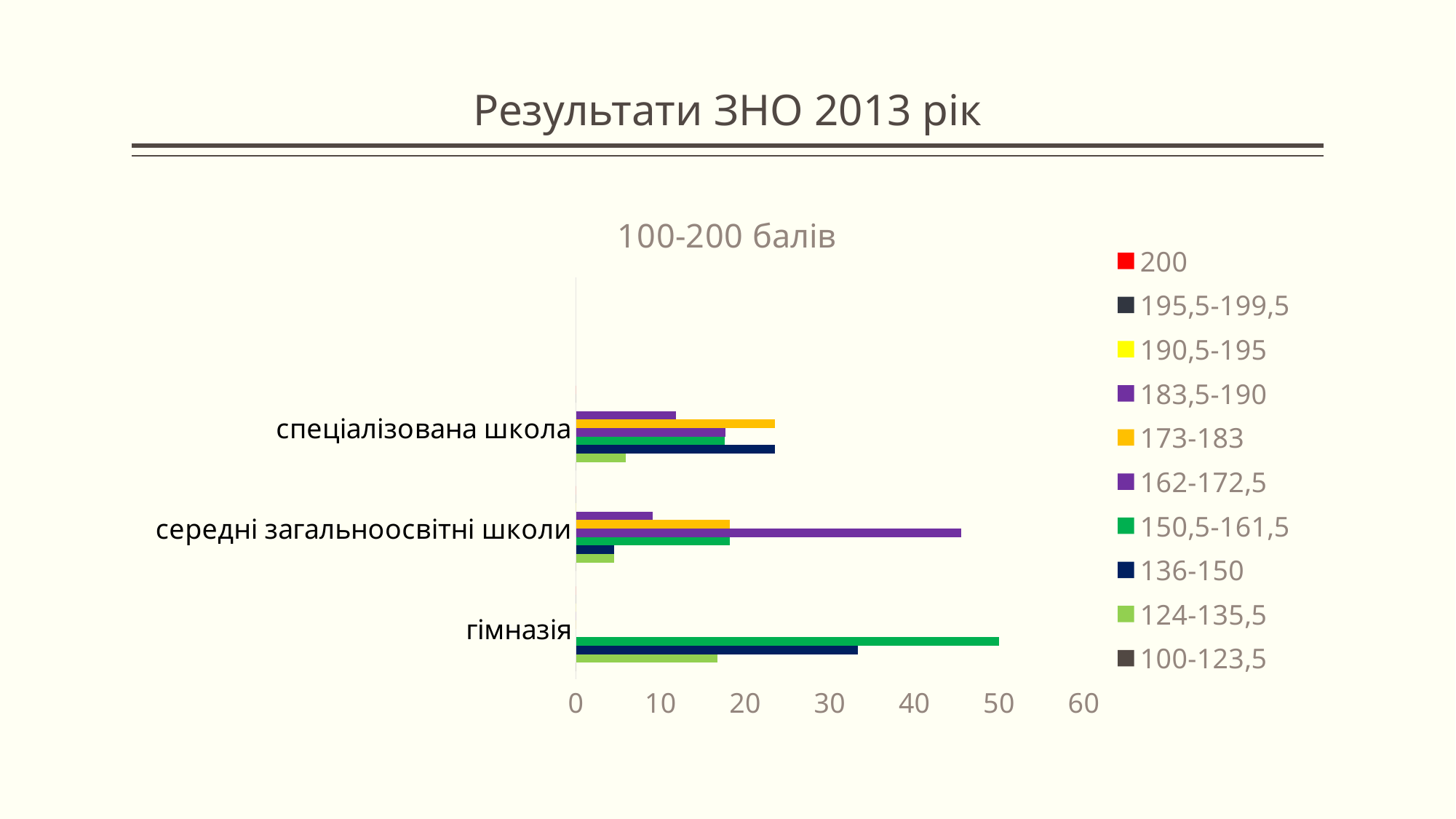
How many series does the chart's legend list? 10 Which is larger: the 162-172,5 value for середні загальноосвітні школи or the 162-172,5 value for спеціалізована школа? середні загальноосвітні школи Which series has the longest bar for середні загальноосвітні школи? 162-172,5 Is the value of the 136-150 series for гімназія greater or less than 20? greater Is the value of the 162-172,5 series for середні загальноосвітні школи greater or less than 40? greater Which series has the longest bar for гімназія? 150,5-161,5 How many categories are shown on the vertical axis of the chart? 3 Is the value of the 124-135,5 series for спеціалізована школа greater or less than 10? less What kind of chart is shown on the slide? bar chart What is the title of the chart? 100-200 балів Which series has the shortest bar for гімназія? 124-135,5